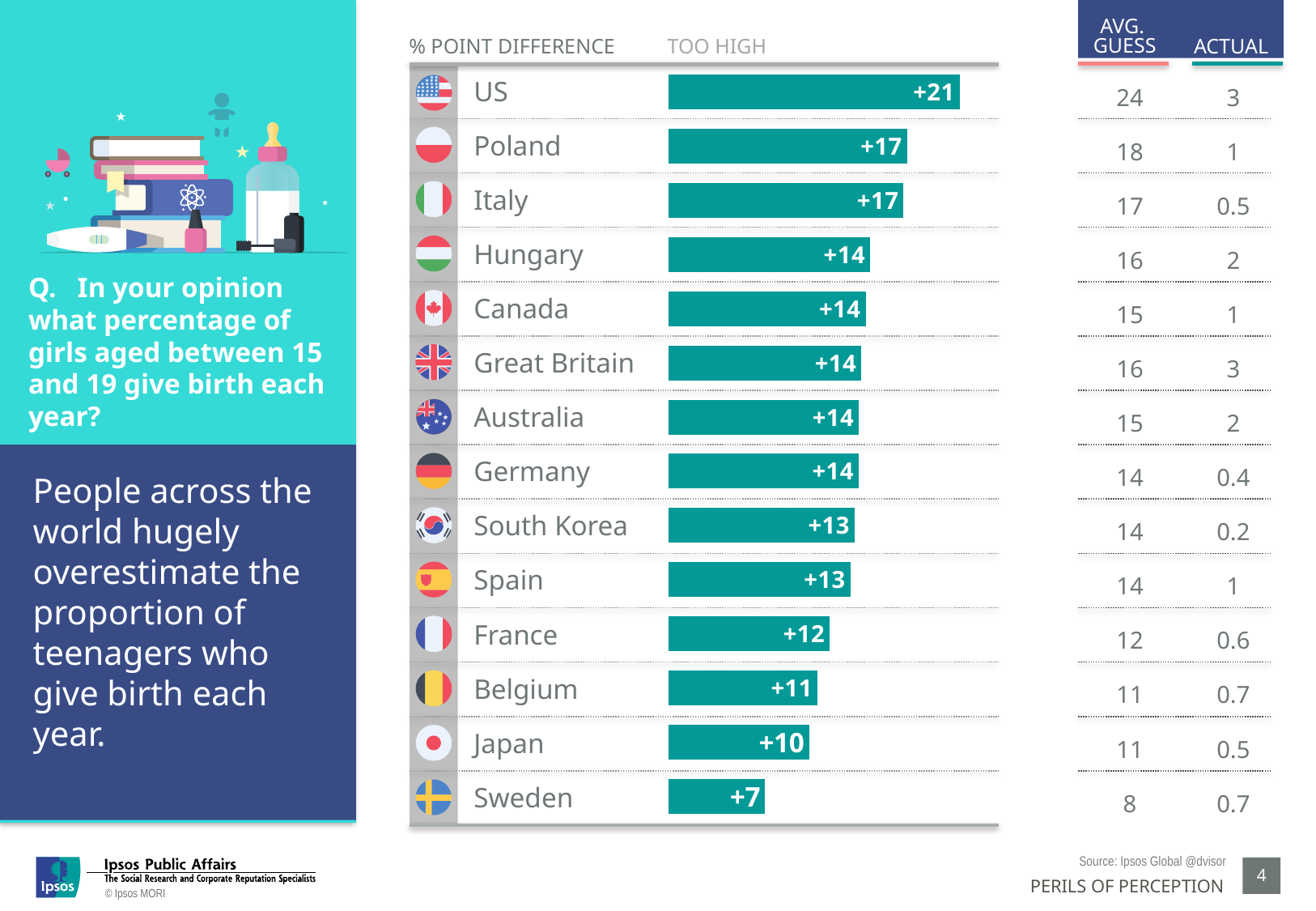
How many countries are shown in the bar chart? 14 Which has a larger % point difference, France or Japan? France What is the average guess for Italy? 17 Which country has the lowest % point difference? Sweden What is the % point difference shown for Sweden? +7 What kind of chart is used to show the % point difference? Bar chart What is the label above the bars in the chart? TOO HIGH What is the actual value for South Korea? 0.2 What is the difference between the % point difference for the US and for Poland? 4 Which country has the highest % point difference? US What is the % point difference shown for the US? +21 What is the % point difference shown for Belgium? +11